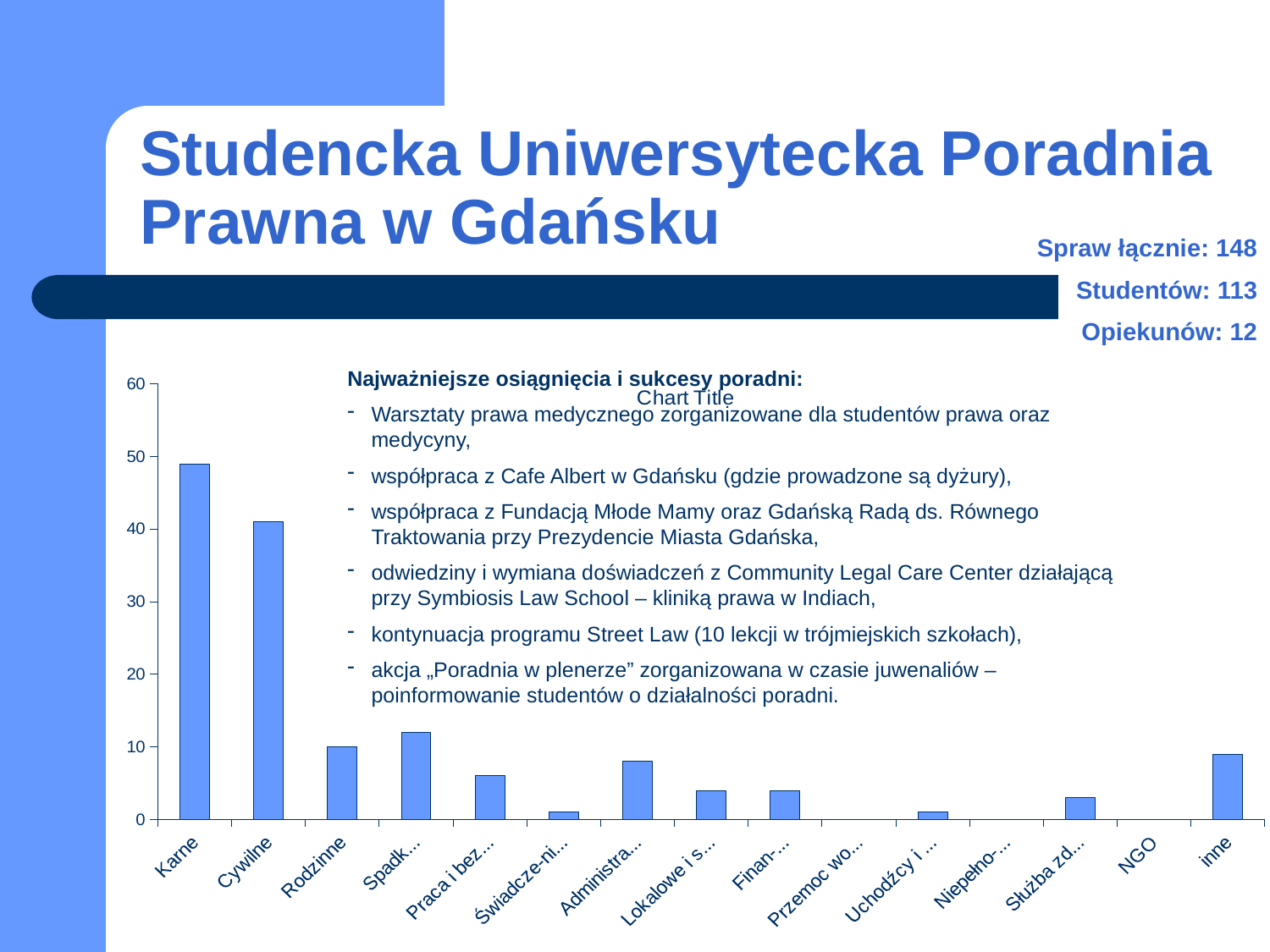
How many categories are shown on the x axis of the chart? 15 What is the title shown above the chart? Chart Title Is the value for Karne greater or less than 40? greater What is the value for Rodzinne in the chart? 10 Is the value for Spadk... greater or less than 10? greater Which category has the highest value in the chart? Karne Which is larger, the value for Administra... or the value for Lokalowe i s...? Administra... Is the value for Cywilne greater or less than 50? less Which is larger, the value for Karne or the value for Cywilne? Karne What kind of chart is shown on the slide? bar chart